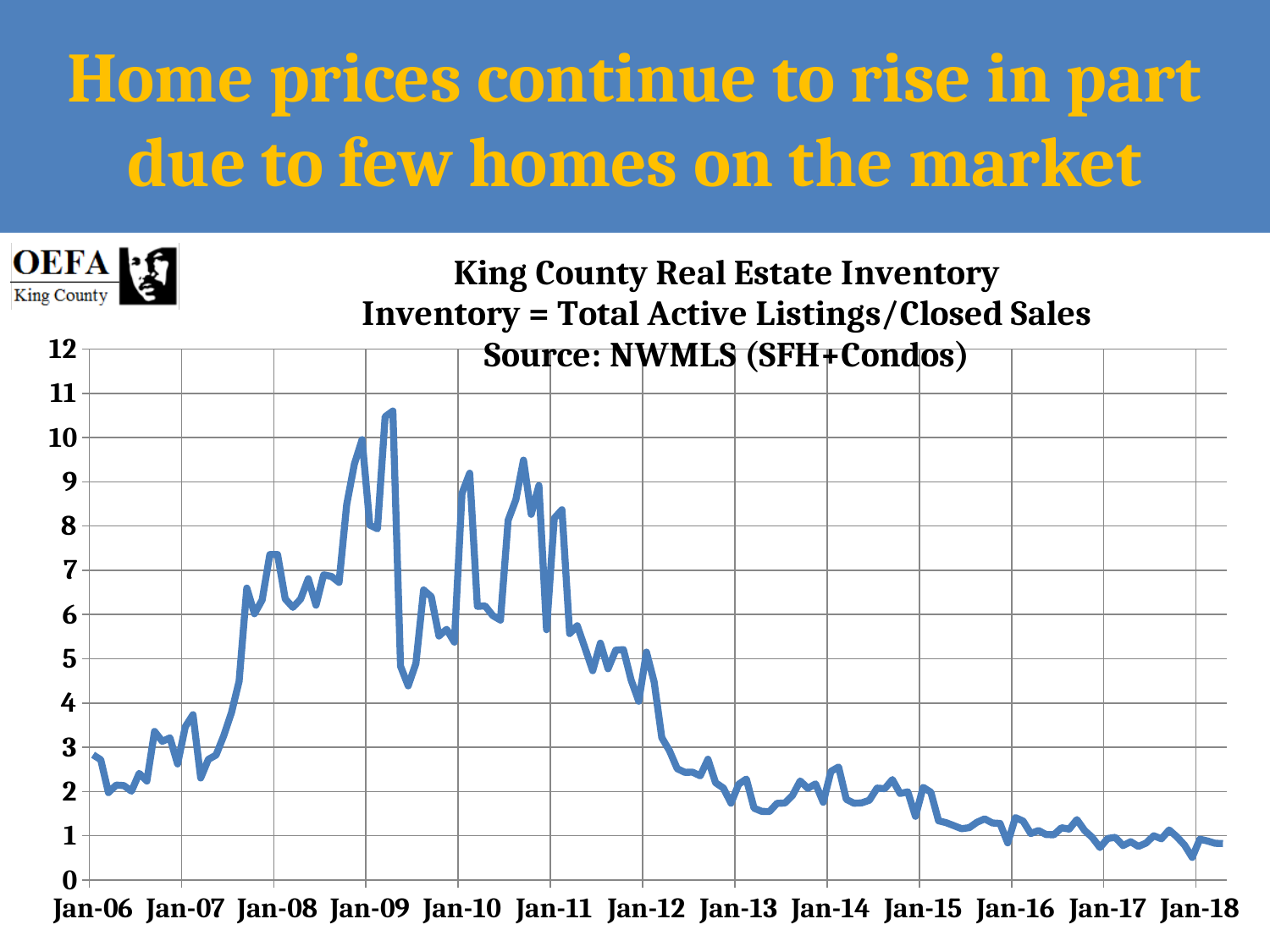
Is the value at Jan-14 greater or less than 4? less Do the values generally rise or fall between Jan-12 and Jan-18? fall What is the title of the chart? King County Real Estate Inventory Is the value at Jan-18 greater or less than 2? less Is the highest value reached by the line greater or less than 10? greater Do the values generally rise or fall between Jan-06 and Jan-09? rise What kind of chart is shown on the slide? line chart What source is cited for the chart's data? NWMLS (SFH+Condos) How many year labels are shown on the x axis? 13 Which is larger, the value at Jan-10 or the value at Jan-16? Jan-10